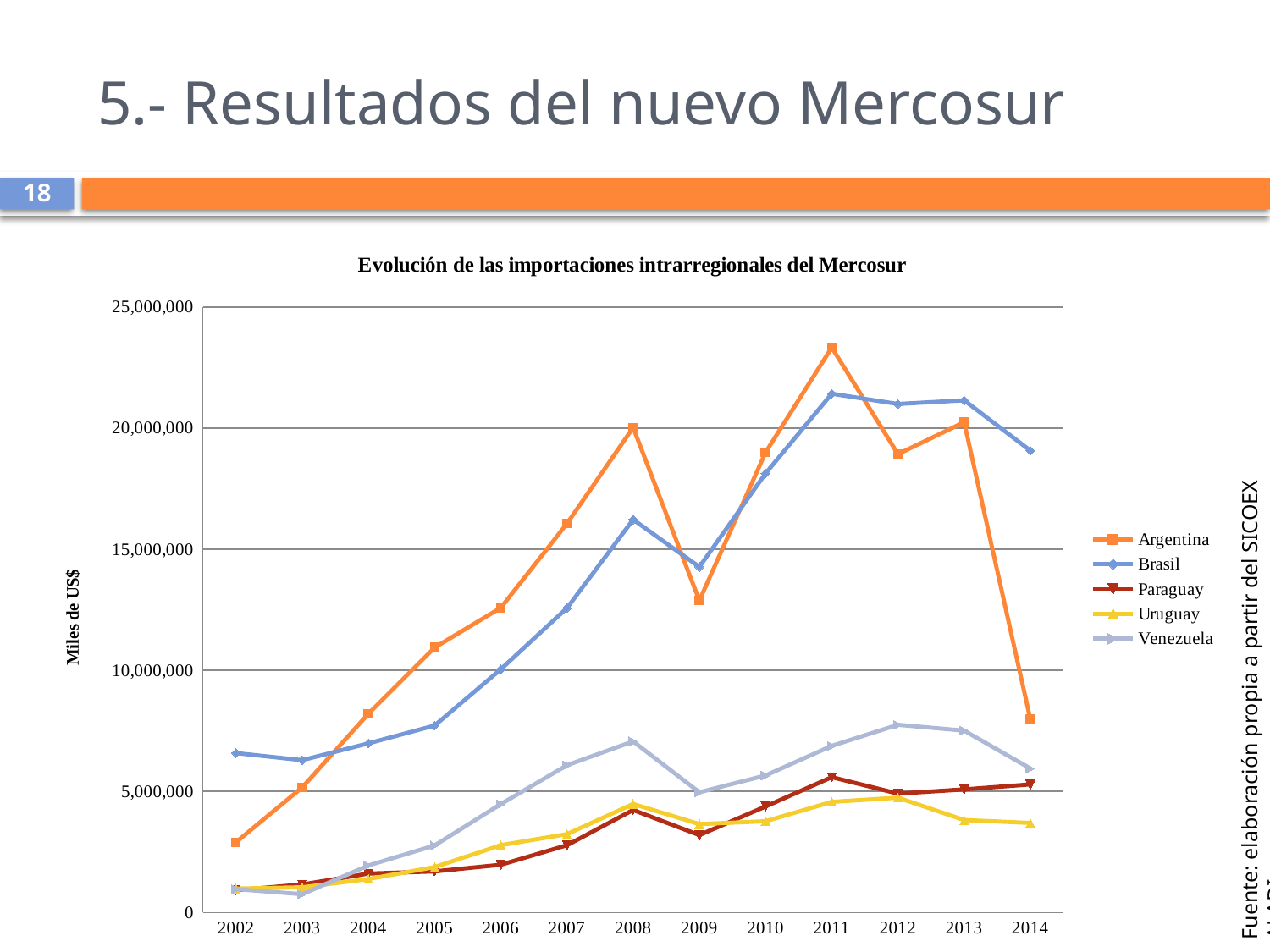
How many series does the legend list? 5 In 2014, which is larger, the value for Brasil or the value for Argentina? Brasil What is the label of the y axis? Miles de US$ Is the value for Argentina in 2014 greater or less than 10,000,000? less Is the value for Argentina in 2011 greater or less than 20,000,000? greater Which series has the highest value in 2011? Argentina What is the title of the chart? Evolución de las importaciones intrarregionales del Mercosur Does the value for Brasil rise or fall from 2002 to 2011? rise How many years are plotted along the x axis? 13 What kind of chart is shown on the slide? line chart Which series has the lowest value in 2014? Uruguay Is the value for Venezuela in 2012 greater or less than 5,000,000? greater